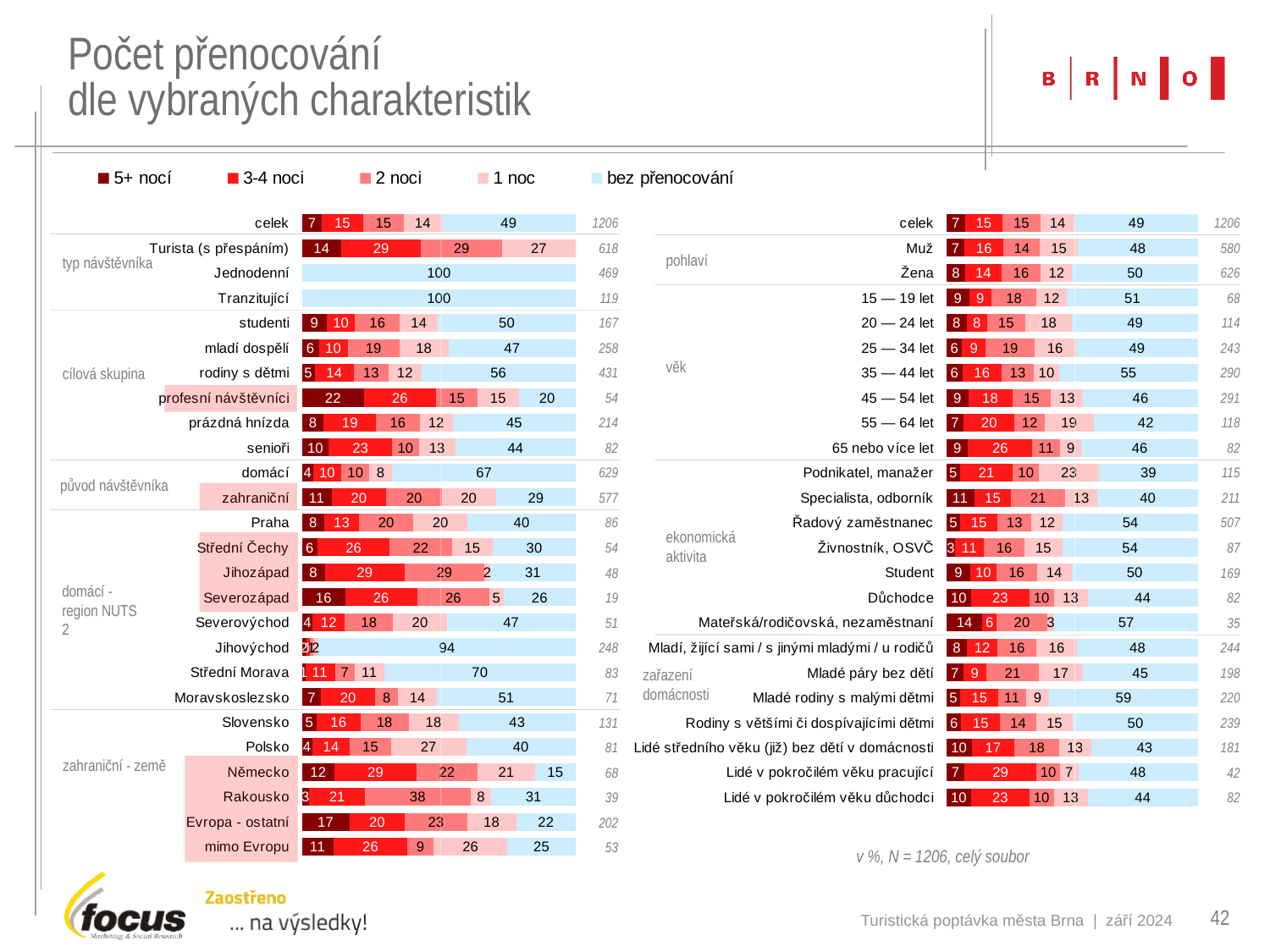
On the left chart, which has the larger 'bez přenocování' value, 'domácí' or 'zahraniční'? domácí On the right chart, what is the difference between the 'bez přenocování' values for 'Žena' and 'Muž'? 2 How many series does the legend list? 5 What is the N (sample size) shown for 'celek' on the left chart? 1206 What kind of chart is shown on the slide? stacked bar chart On the left chart, what is the value of 'bez přenocování' for 'domácí'? 67 On the left chart, what is the value of '2 noci' for 'Rakousko'? 38 On the right chart, what is the value of '3-4 noci' for '65 nebo více let'? 26 On the right chart, what is the value of 'bez přenocování' for 'Žena'? 50 On the right chart, what is the value of 'bez přenocování' for 'Mladé rodiny s malými dětmi'? 59 On the left chart, what is the value of 'bez přenocování' for 'Jednodenní'? 100 On the left chart, which of the 'cílová skupina' categories has the highest 'bez přenocování' value? rodiny s dětmi